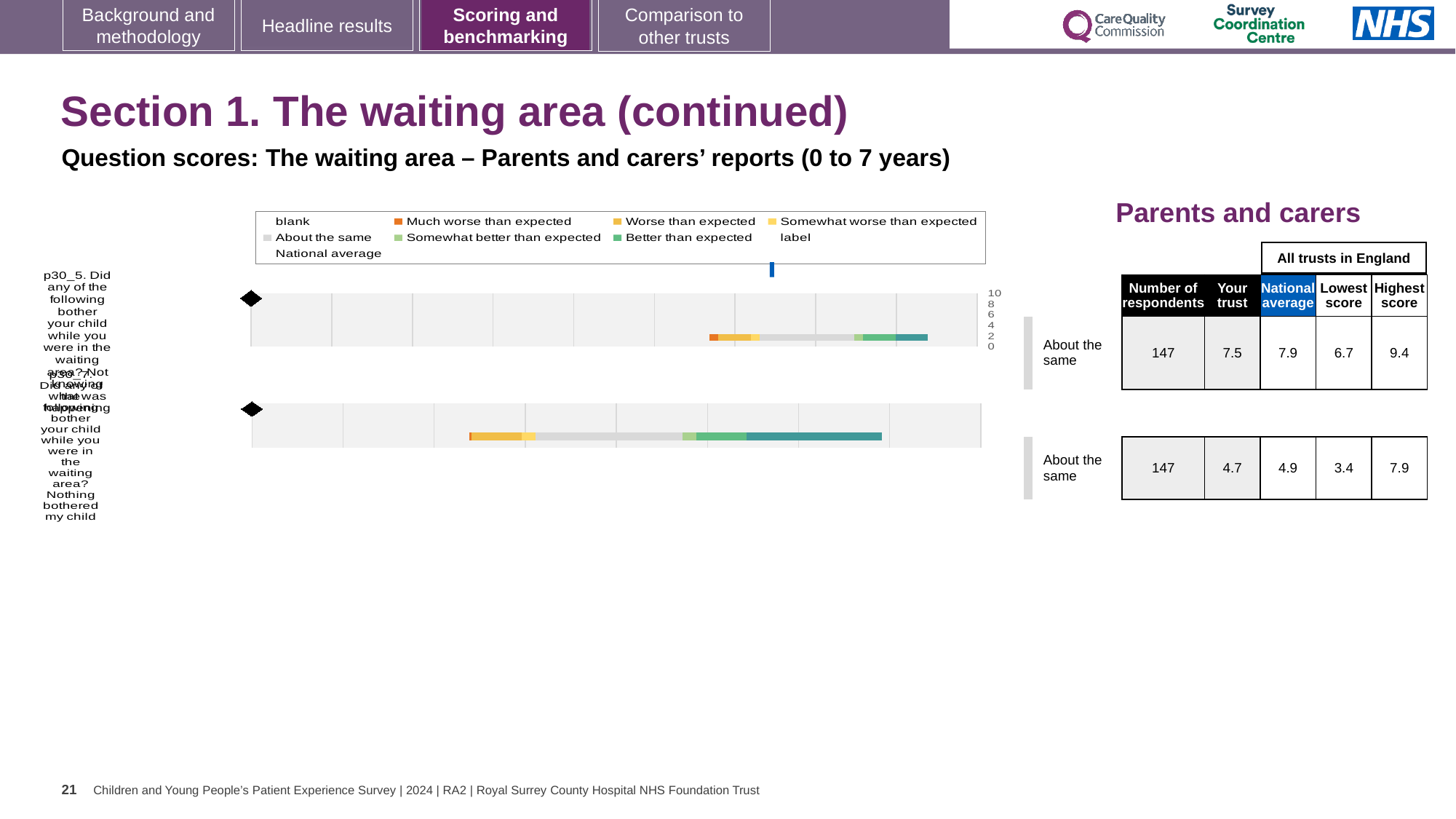
What is the 'Your trust' score for question p30_7 (Nothing bothered my child)? 4.7 What benchmark category is the trust placed in for question p30_7? About the same What is the 'Your trust' score for question p30_5 (Did any of the following bother your child while you were in the waiting area? Not knowing what was happening)? 7.5 How many questions (bars) are plotted in the chart? 2 Which is larger for question p30_5: the trust's score or the national average? National average What kind of chart is shown on the slide? bar chart What is the highest score among all trusts in England for question p30_7? 7.9 What is the difference between the highest score (9.4) and the lowest score (6.7) for question p30_5? 2.7 How many respondents answered question p30_5? 147 What is the difference between the national average (4.9) and the trust's score (4.7) for question p30_7? 0.2 What is the national average score for question p30_5? 7.9 How many entries does the chart legend list? 9